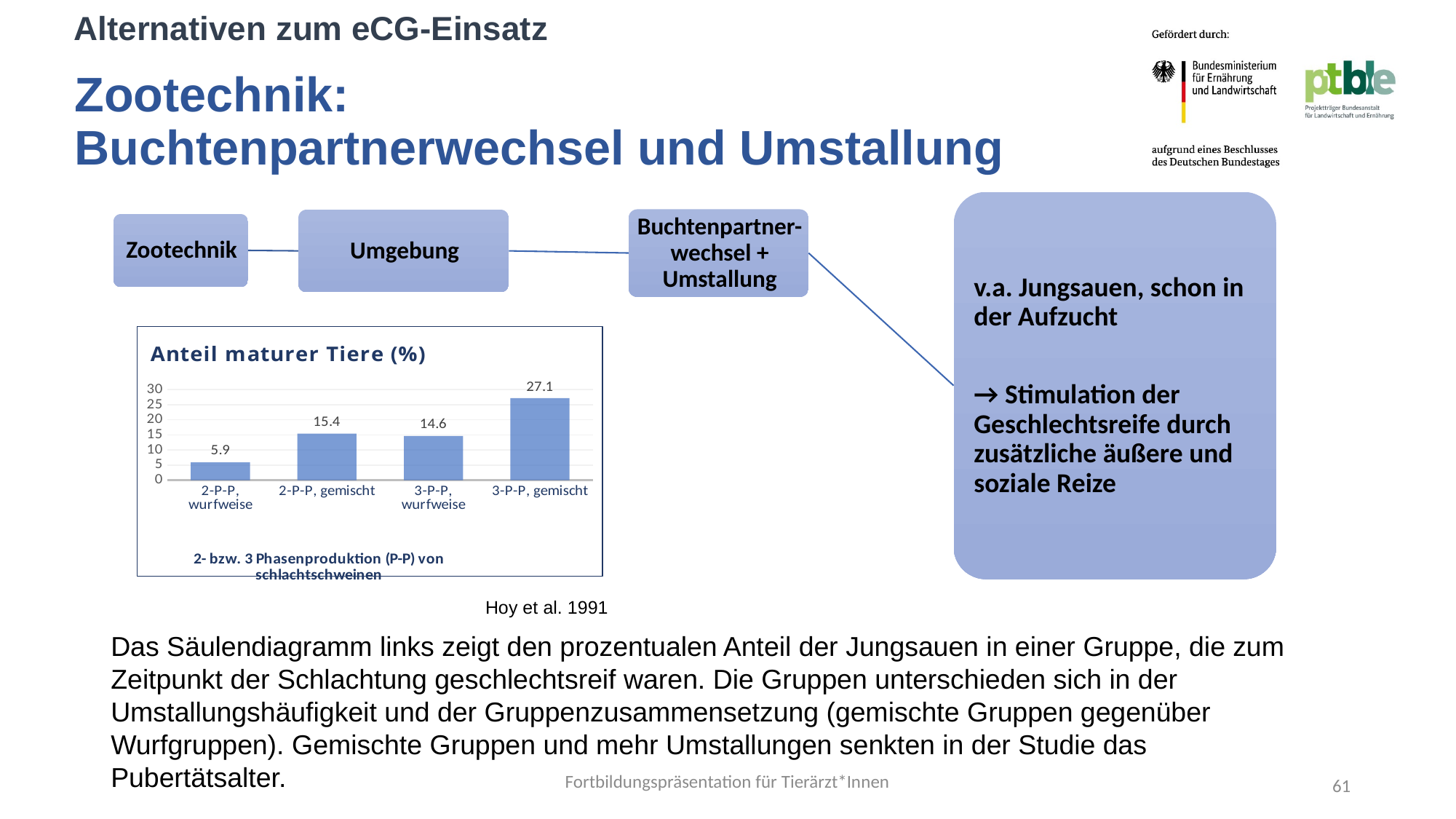
What is the value for "3-P-P, gemischt" in the chart "Anteil maturer Tiere (%)"? 27.1 What kind of chart is "Anteil maturer Tiere (%)"? bar chart What is the value for "3-P-P, wurfweise" in the chart "Anteil maturer Tiere (%)"? 14.6 What is the x-axis label of the chart "Anteil maturer Tiere (%)"? 2- bzw. 3 Phasenproduktion (P-P) von schlachtschweinen Which is larger in the chart "Anteil maturer Tiere (%)": the value for "2-P-P, gemischt" or "3-P-P, wurfweise"? 2-P-P, gemischt What is the value for "2-P-P, wurfweise" in the chart "Anteil maturer Tiere (%)"? 5.9 Which category has the highest value in the chart "Anteil maturer Tiere (%)"? 3-P-P, gemischt Is the value for "3-P-P, gemischt" greater or less than 25 in the chart "Anteil maturer Tiere (%)"? greater What is the difference between the values for "3-P-P, gemischt" and "2-P-P, wurfweise" in the chart "Anteil maturer Tiere (%)"? 21.2 How many categories are shown in the chart "Anteil maturer Tiere (%)"? 4 Which category has the lowest value in the chart "Anteil maturer Tiere (%)"? 2-P-P, wurfweise What is the value for "2-P-P, gemischt" in the chart "Anteil maturer Tiere (%)"? 15.4